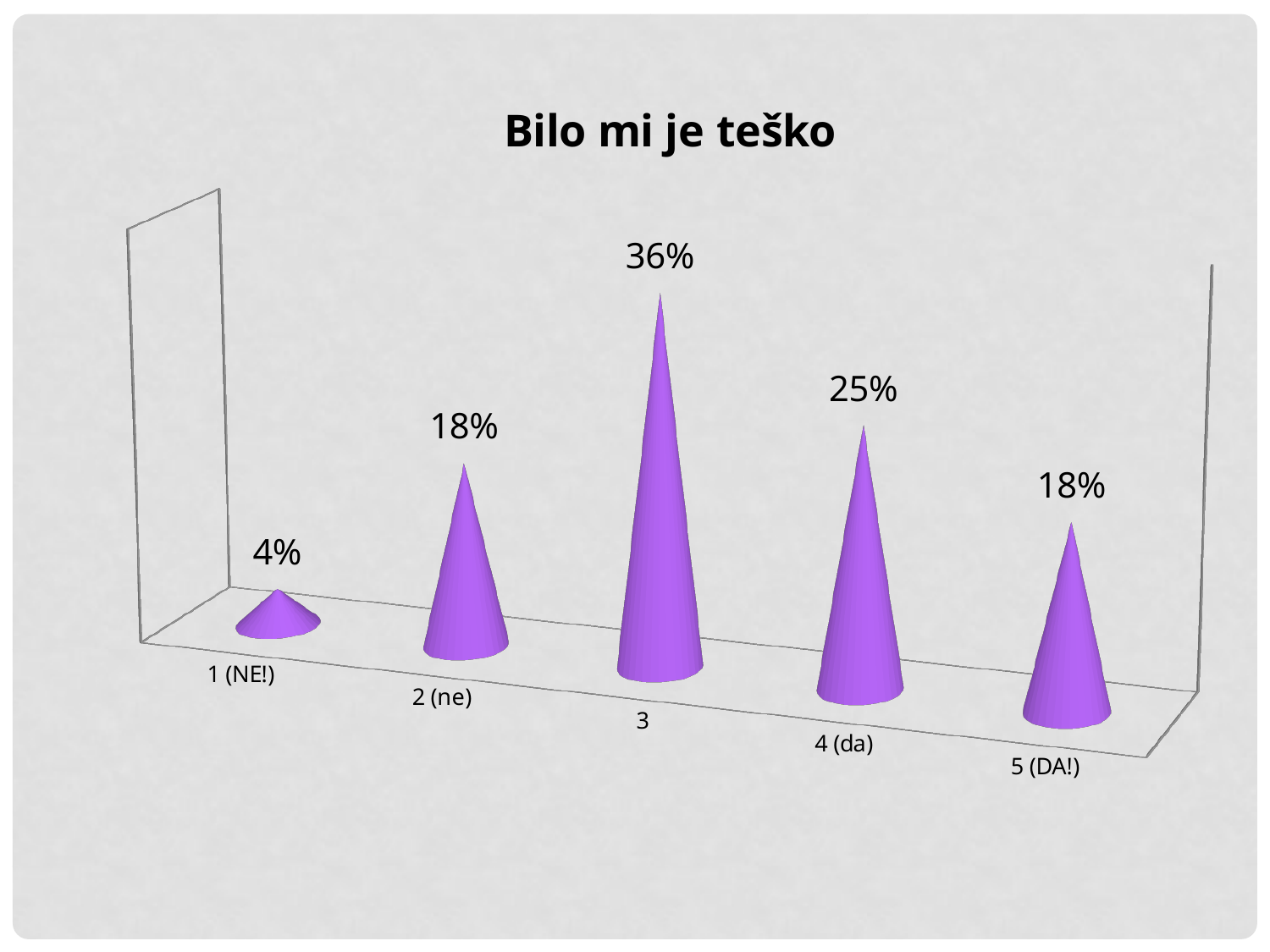
Which category has the highest value? 3 What is the difference between the values for 3 and 4 (da)? 11% How many categories are shown on the chart? 5 What is the value for 1 (NE!)? 4% What is the title of the chart? Bilo mi je teško What is the value for category 3? 36% What is the difference between the values for 2 (ne) and 1 (NE!)? 14% What kind of chart is this? bar chart Which category has the lowest value? 1 (NE!) What is the value for 5 (DA!)? 18% Which is larger, the value for 4 (da) or the value for 5 (DA!)? 4 (da) What is the value for 4 (da)? 25%